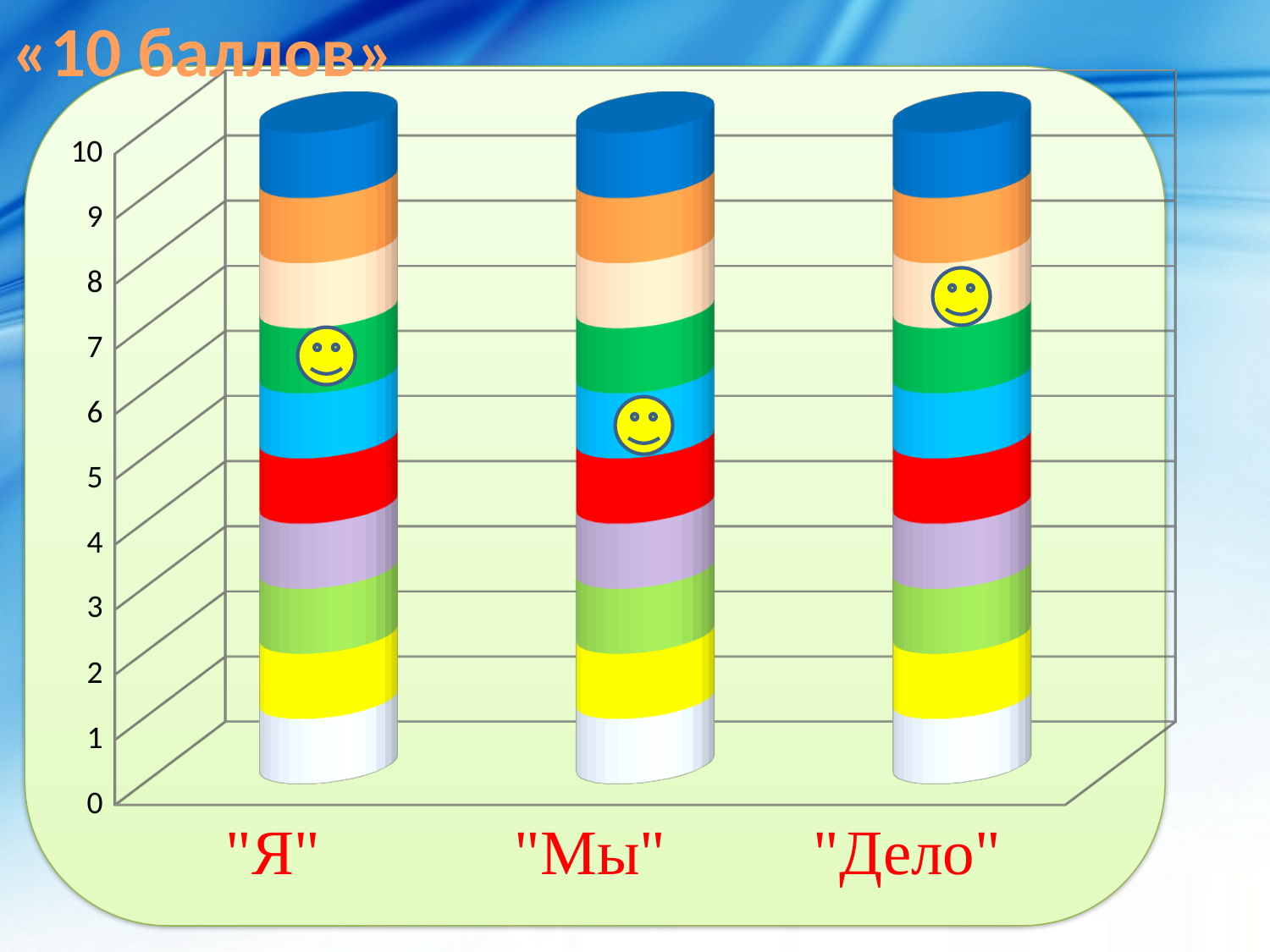
Is the smiley face on the "Дело" bar positioned above or below the 7 gridline? above Is the smiley face on the "Я" bar positioned above or below the 5 gridline? above What are the three category labels on the x axis of the chart? "Я", "Мы", "Дело" What value does the top of the "Дело" bar reach on the vertical axis? 10 What is the title shown above the chart? «10 баллов» Do the bars for "Я", "Мы" and "Дело" reach the same height? yes Is the smiley face on the "Мы" bar positioned above or below the 7 gridline? below How many categories are shown on the x axis of the chart? 3 How many coloured segments make up each stacked bar? 10 What is the highest value marked on the vertical axis of the chart? 10 What kind of chart is shown on the slide? stacked bar chart What value does the top of the "Я" bar reach on the vertical axis? 10